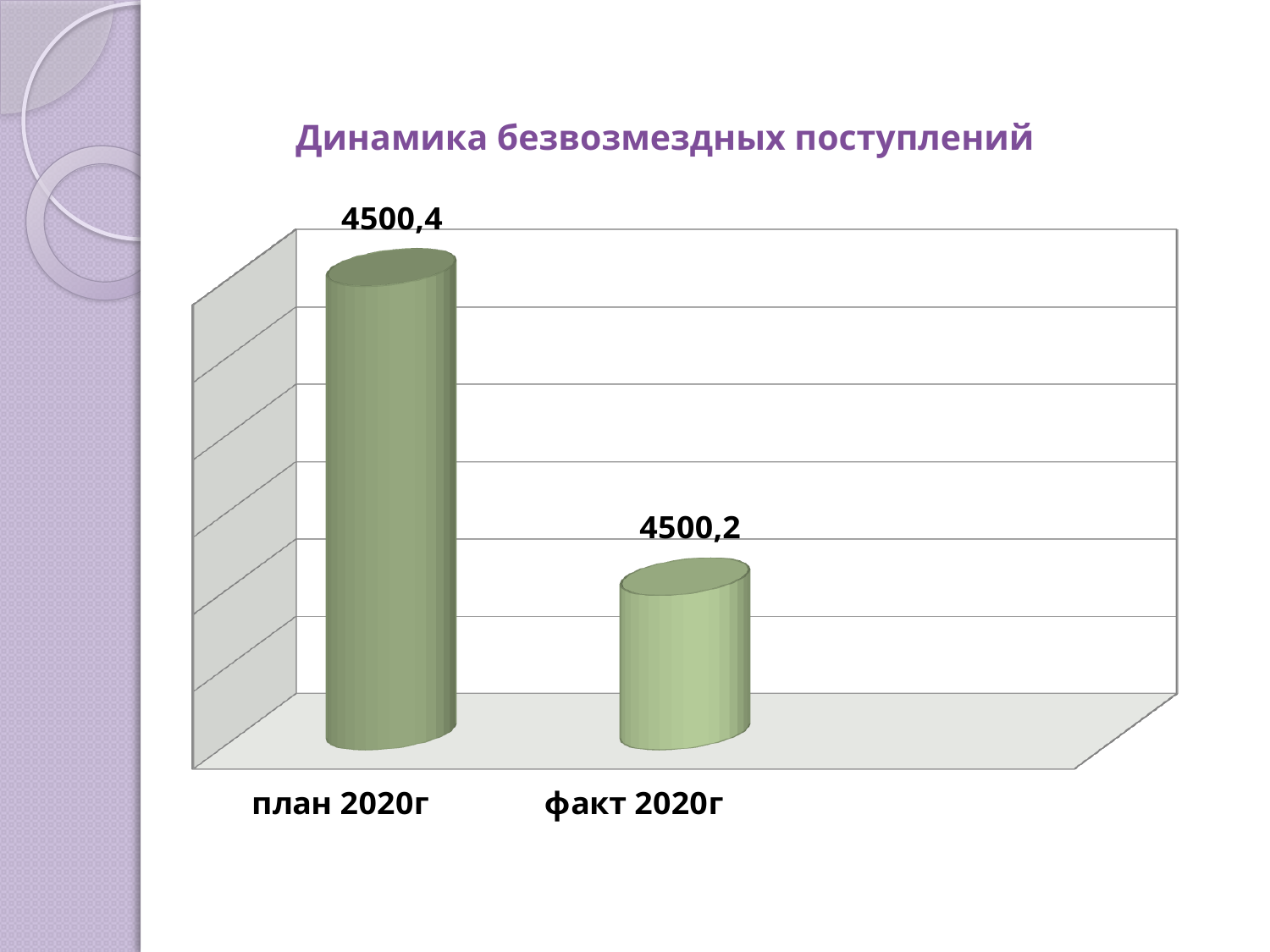
Which category has the lowest value? факт 2020г Do the values rise or fall from план 2020г to факт 2020г? fall Which category has the highest value? план 2020г What is the difference between the values for план 2020г and факт 2020г? 0,2 What is the label of the first category on the x axis? план 2020г What is the value for план 2020г? 4500,4 What kind of chart is shown on the slide? bar chart Which is larger, the value for план 2020г or the value for факт 2020г? план 2020г What is the title of the chart? Динамика безвозмездных поступлений What is the value for факт 2020г? 4500,2 How many categories are shown in the chart? 2